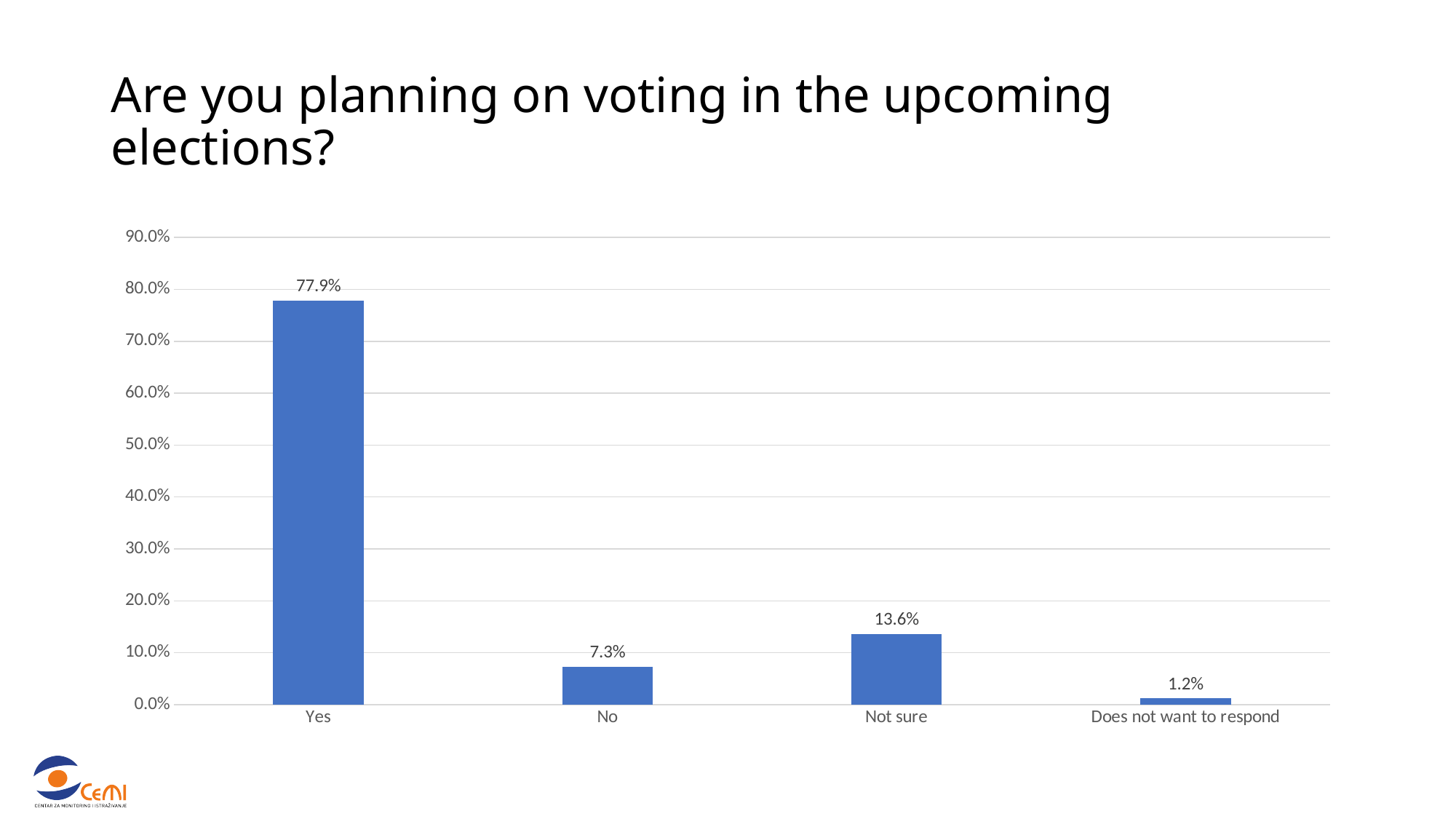
Which is larger, the value for "No" or the value for "Not sure"? Not sure What percentage of respondents answered "Yes"? 77.9% How many response categories are shown on the x axis? 4 What is the difference in percentage points between "Not sure" and "No"? 6.3 Which response category has the highest value? Yes Is the value for "Yes" greater or less than 70.0%? greater What is the difference in percentage points between "Yes" and "Not sure"? 64.3 What percentage of respondents answered "No"? 7.3% What percentage of respondents chose "Does not want to respond"? 1.2% What kind of chart is shown on the slide? Bar chart What percentage of respondents answered "Not sure"? 13.6% Which response category has the lowest value? Does not want to respond